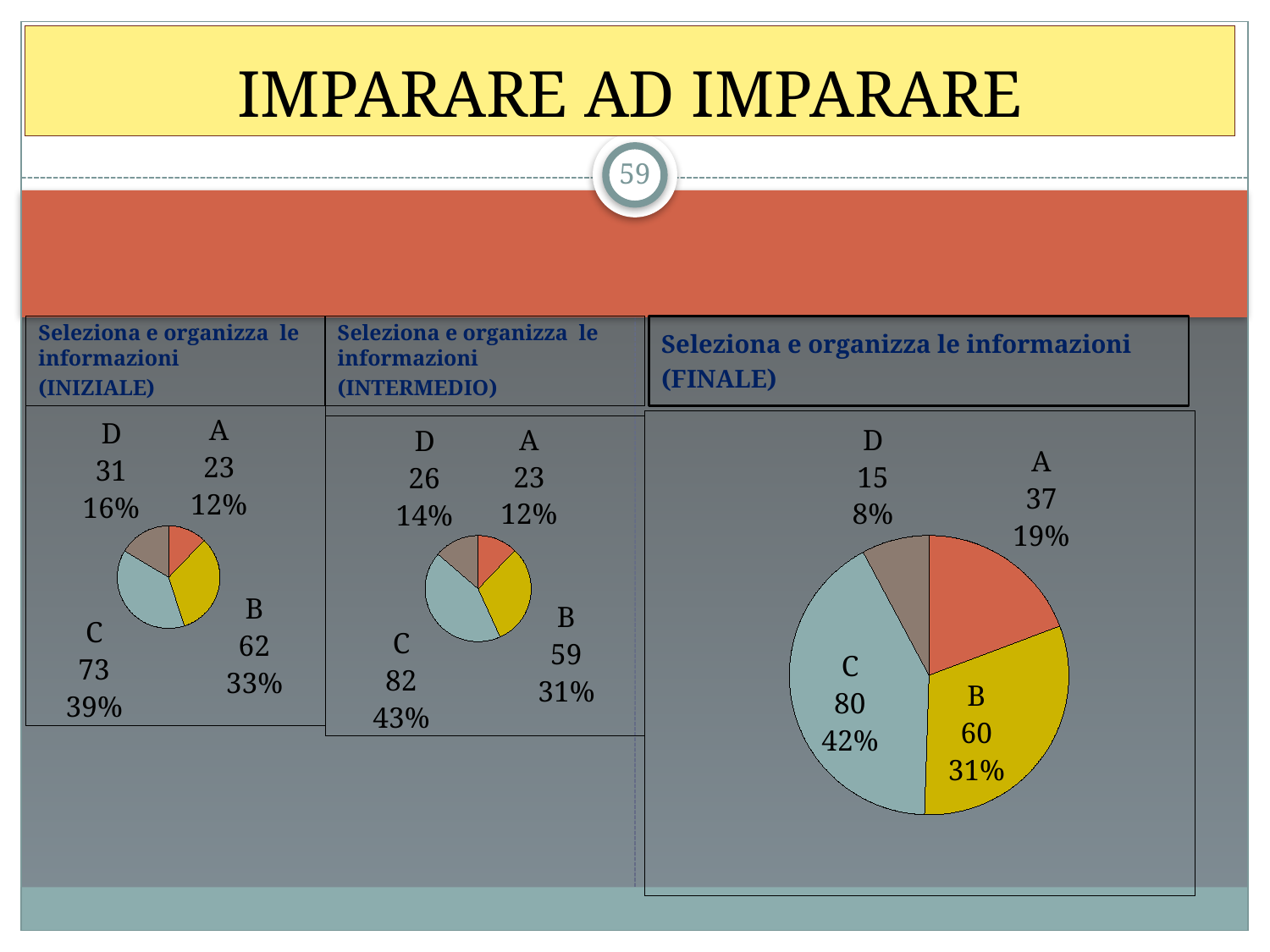
In the FINALE pie chart, what share of the pie does category D represent? 8% In the FINALE pie chart, which is larger, the value for B or the value for A? B In the INTERMEDIO pie chart, what share of the pie does category C represent? 43% In the INTERMEDIO pie chart, what is the difference between the values for C and B? 23 In the INTERMEDIO pie chart, what is the value for category D? 26 In the INIZIALE pie chart, which category has the lowest value? A What type of chart is used in the INIZIALE panel? Pie chart How many slices does the FINALE pie chart have? 4 In the INIZIALE pie chart, what share of the pie does category B represent? 33% In the FINALE pie chart, what is the value for category A? 37 In the INIZIALE pie chart, what is the value for category C? 73 In the FINALE pie chart, which category has the highest value? C